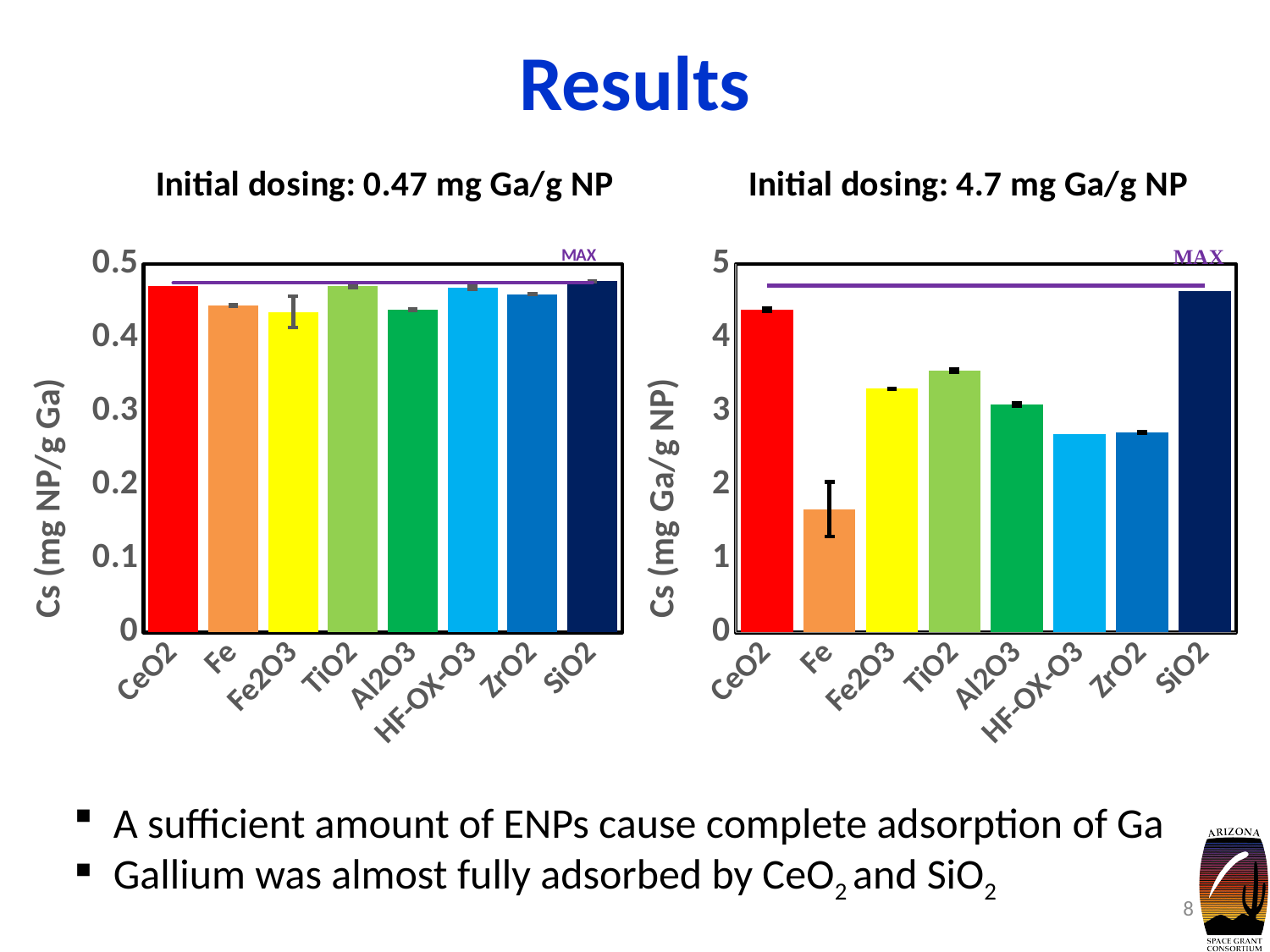
What is the y-axis label of the chart titled "Initial dosing: 4.7 mg Ga/g NP"? Cs (mg Ga/g NP) What kind of chart is the chart titled "Initial dosing: 4.7 mg Ga/g NP"? bar chart In the chart titled "Initial dosing: 4.7 mg Ga/g NP", which is larger, the value for TiO2 or the value for Fe2O3? TiO2 In the chart titled "Initial dosing: 4.7 mg Ga/g NP", is the value for CeO2 greater or less than 4? greater In the chart titled "Initial dosing: 4.7 mg Ga/g NP", which category has the lowest value? Fe How many categories are shown on the x axis of the chart titled "Initial dosing: 0.47 mg Ga/g NP"? 8 In the chart titled "Initial dosing: 0.47 mg Ga/g NP", is the value for CeO2 greater or less than 0.3? greater In the chart titled "Initial dosing: 4.7 mg Ga/g NP", which category has the highest value? SiO2 In the chart titled "Initial dosing: 0.47 mg Ga/g NP", is the value for Fe2O3 greater or less than 0.4? greater In the chart titled "Initial dosing: 4.7 mg Ga/g NP", which is larger, the value for Al2O3 or the value for Fe? Al2O3